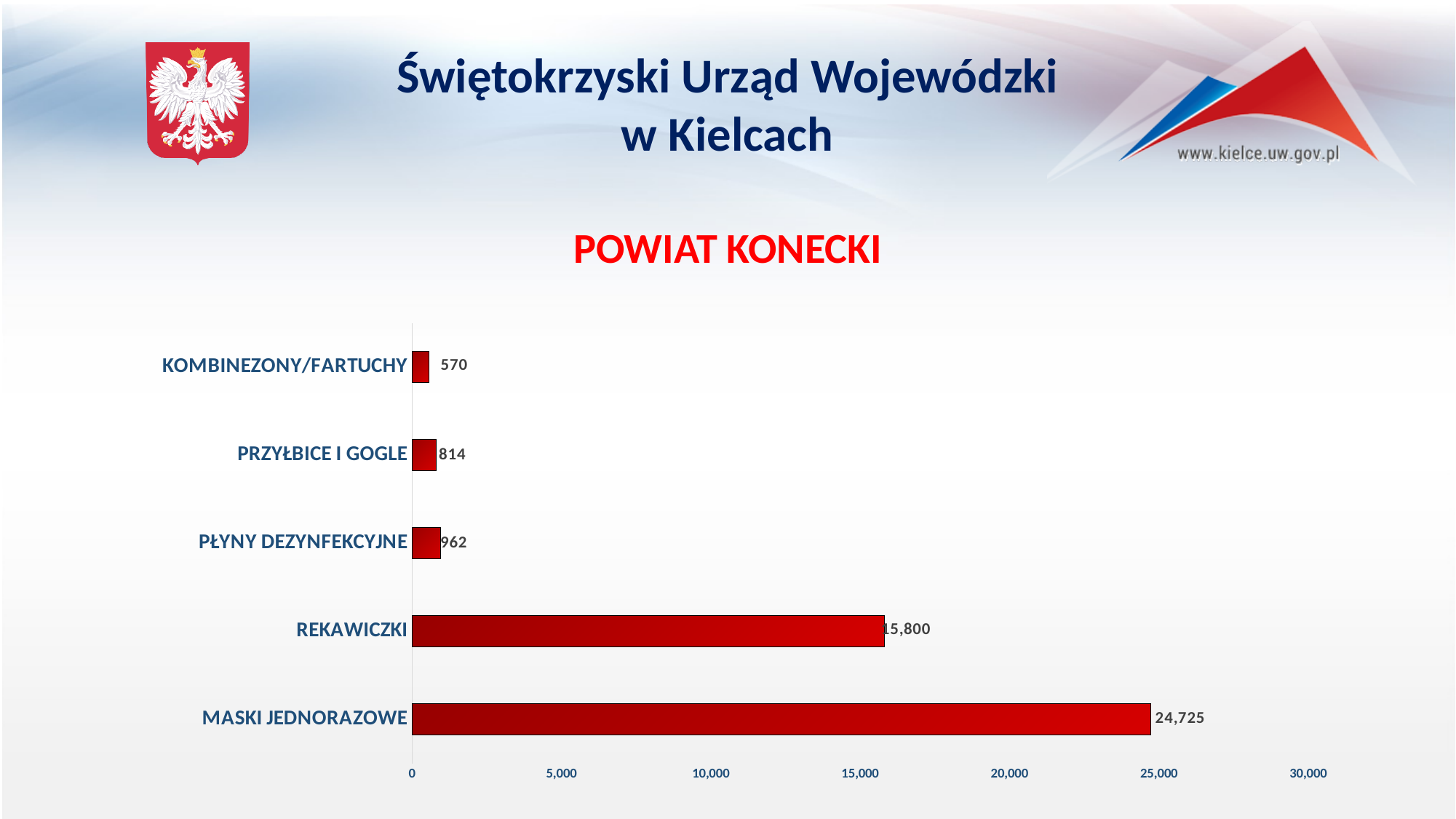
Which is larger, the value for PRZYŁBICE I GOGLE or the value for PŁYNY DEZYNFEKCYJNE? PŁYNY DEZYNFEKCYJNE What is the value for PŁYNY DEZYNFEKCYJNE? 962 What is the value for REKAWICZKI? 15,800 What is the value for KOMBINEZONY/FARTUCHY? 570 What is the value for MASKI JEDNORAZOWE? 24,725 Which category has the lowest value? KOMBINEZONY/FARTUCHY What kind of chart is shown on the slide? bar chart What is the title shown above the chart? POWIAT KONECKI Is the value for REKAWICZKI greater or less than 20,000? less What is the difference between the values for MASKI JEDNORAZOWE and REKAWICZKI? 8,925 Which category has the highest value? MASKI JEDNORAZOWE How many categories are shown in the chart? 5